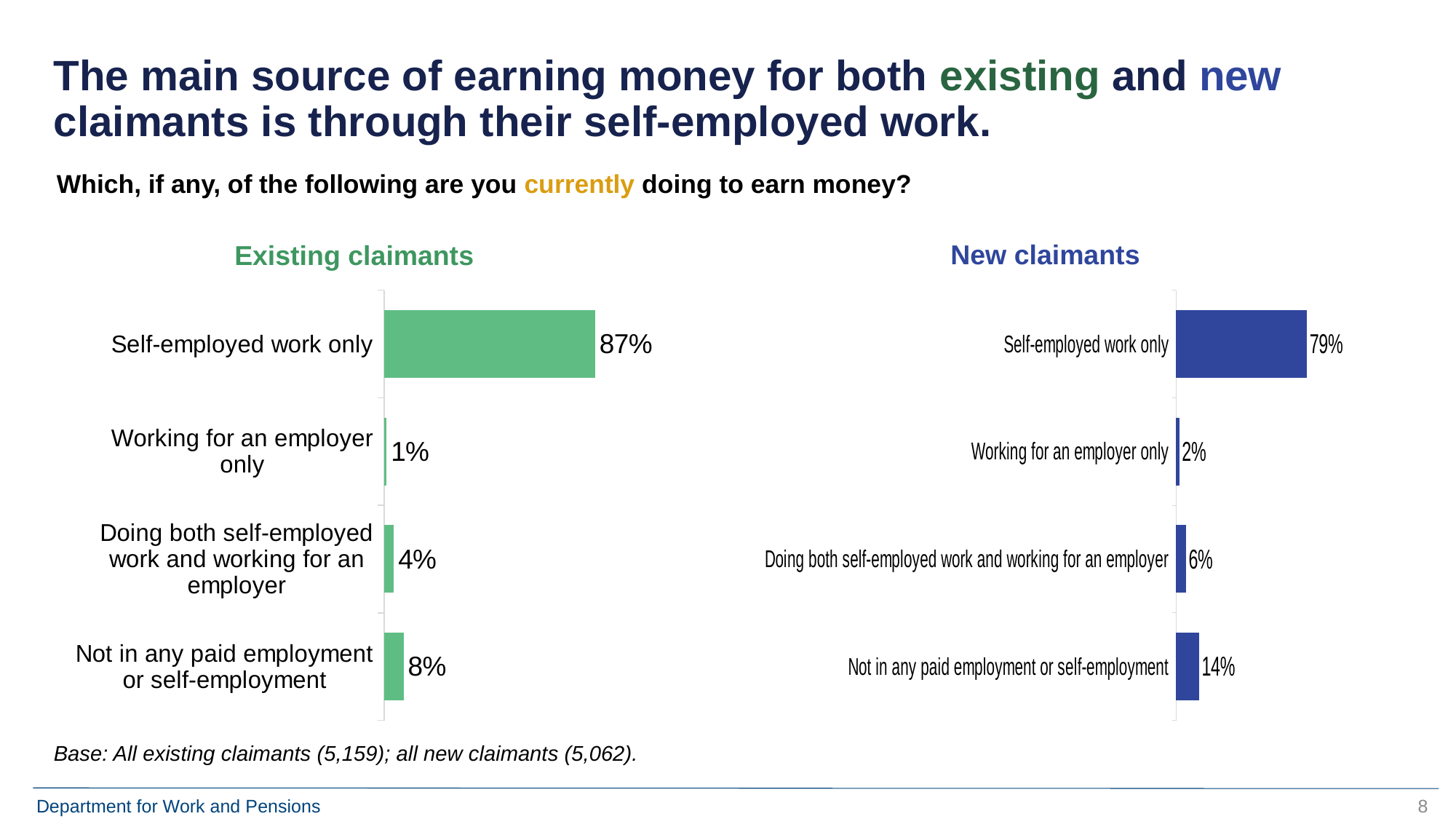
In the New claimants chart, what is the difference between Not in any paid employment or self-employment and Doing both self-employed work and working for an employer? 8 percentage points What is the difference between the Self-employed work only value in the Existing claimants chart and the Self-employed work only value in the New claimants chart? 8 percentage points Which is larger: Not in any paid employment or self-employment in the Existing claimants chart or in the New claimants chart? New claimants In the New claimants chart, what percentage is shown for Working for an employer only? 2% In the New claimants chart, what percentage is shown for Not in any paid employment or self-employment? 14% What type of chart is the New claimants chart? Bar chart In the New claimants chart, which category has the highest value? Self-employed work only In the Existing claimants chart, what percentage is shown for Doing both self-employed work and working for an employer? 4% In the Existing claimants chart, what percentage is shown for Self-employed work only? 87% In the Existing claimants chart, which category has the lowest value? Working for an employer only What colour are the bars in the Existing claimants chart? Green How many categories does the Existing claimants chart show? 4